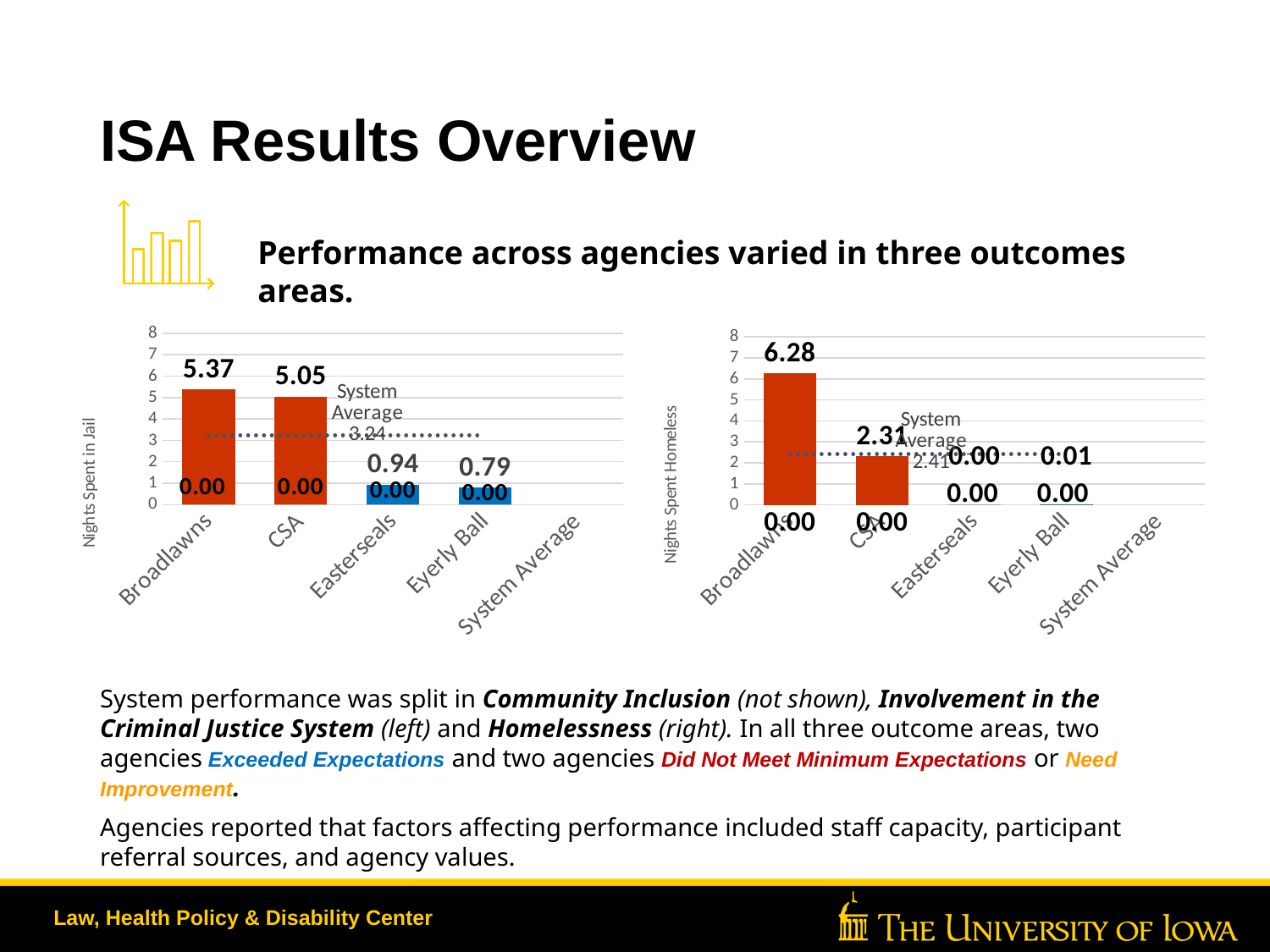
In the left chart (Nights Spent in Jail), what is the value for Broadlawns? 5.37 In the right chart (Nights Spent Homeless), what is the System Average value shown on the dotted line? 2.41 In the left chart (Nights Spent in Jail), what is the value for Easterseals? 0.94 In the right chart (Nights Spent Homeless), what is the value for CSA? 2.31 In the right chart (Nights Spent Homeless), which is larger, the value for Broadlawns or the value for CSA? Broadlawns In the left chart (Nights Spent in Jail), what is the value for CSA? 5.05 In the left chart (Nights Spent in Jail), what is the difference between the values for Broadlawns and CSA? 0.32 In the left chart (Nights Spent in Jail), which agency has the lowest value? Eyerly Ball What type of chart is the left chart (Nights Spent in Jail)? Combination bar and line chart (bars with a dotted system-average line) In the right chart (Nights Spent Homeless), which agency has the highest value? Broadlawns In the left chart (Nights Spent in Jail), what is the System Average value shown on the dotted line? 3.24 In the right chart (Nights Spent Homeless), what is the value for Broadlawns? 6.28